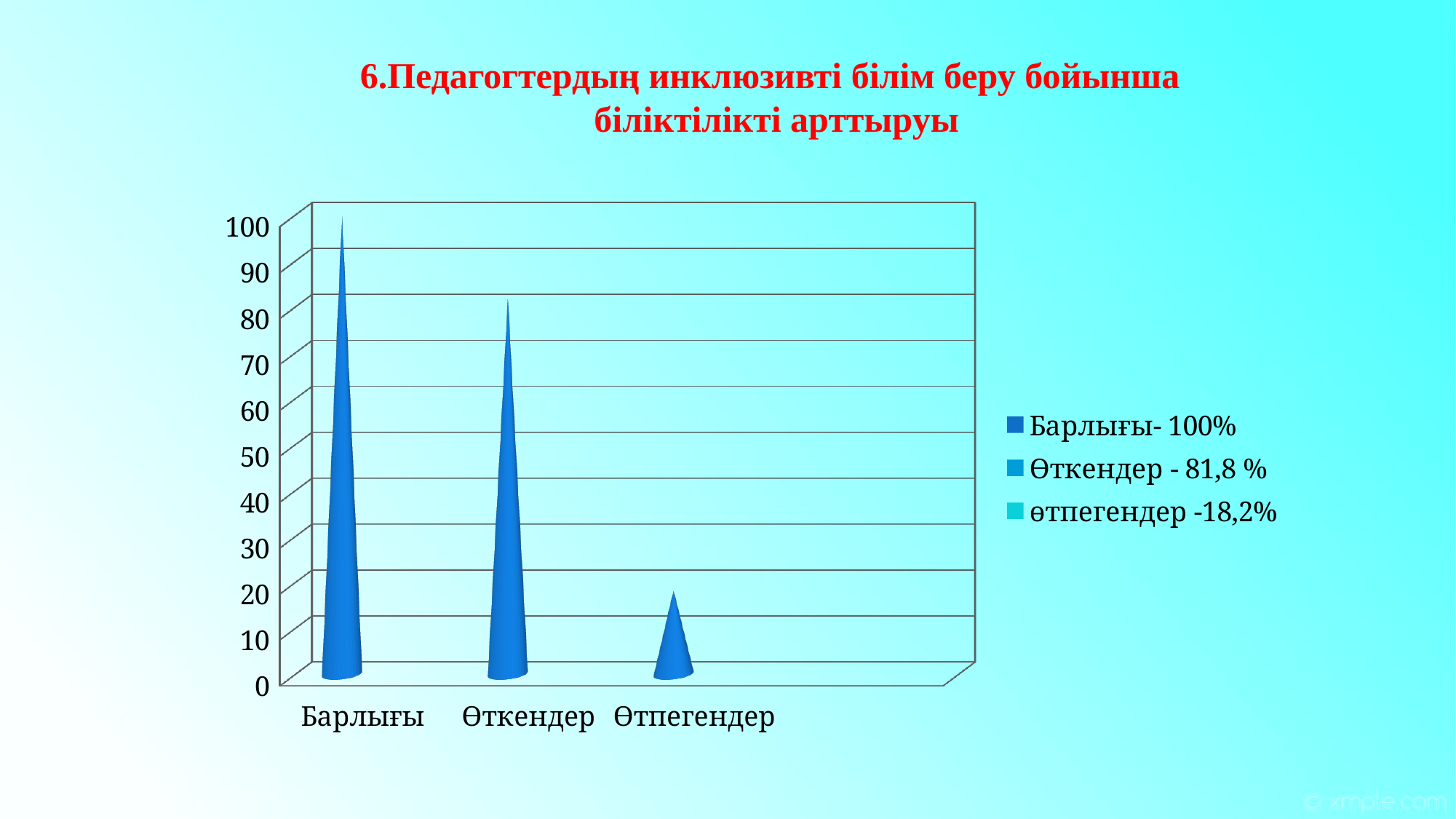
Is the value for Өткендер greater or less than 70? greater What value does the legend give for Өткендер? 81,8 % How many categories are shown on the x axis? 3 Which is larger, the value for Өткендер or the value for Өтпегендер? Өткендер Which category has the lowest value? Өтпегендер What value does the legend give for Барлығы? 100% Is the value for Өтпегендер greater or less than 30? less What is the difference between the values for Барлығы and Өткендер? 18,2% What kind of chart is shown on the slide? Bar chart Which category has the highest value? Барлығы What value does the legend give for өтпегендер? 18,2% How many entries does the legend list? 3